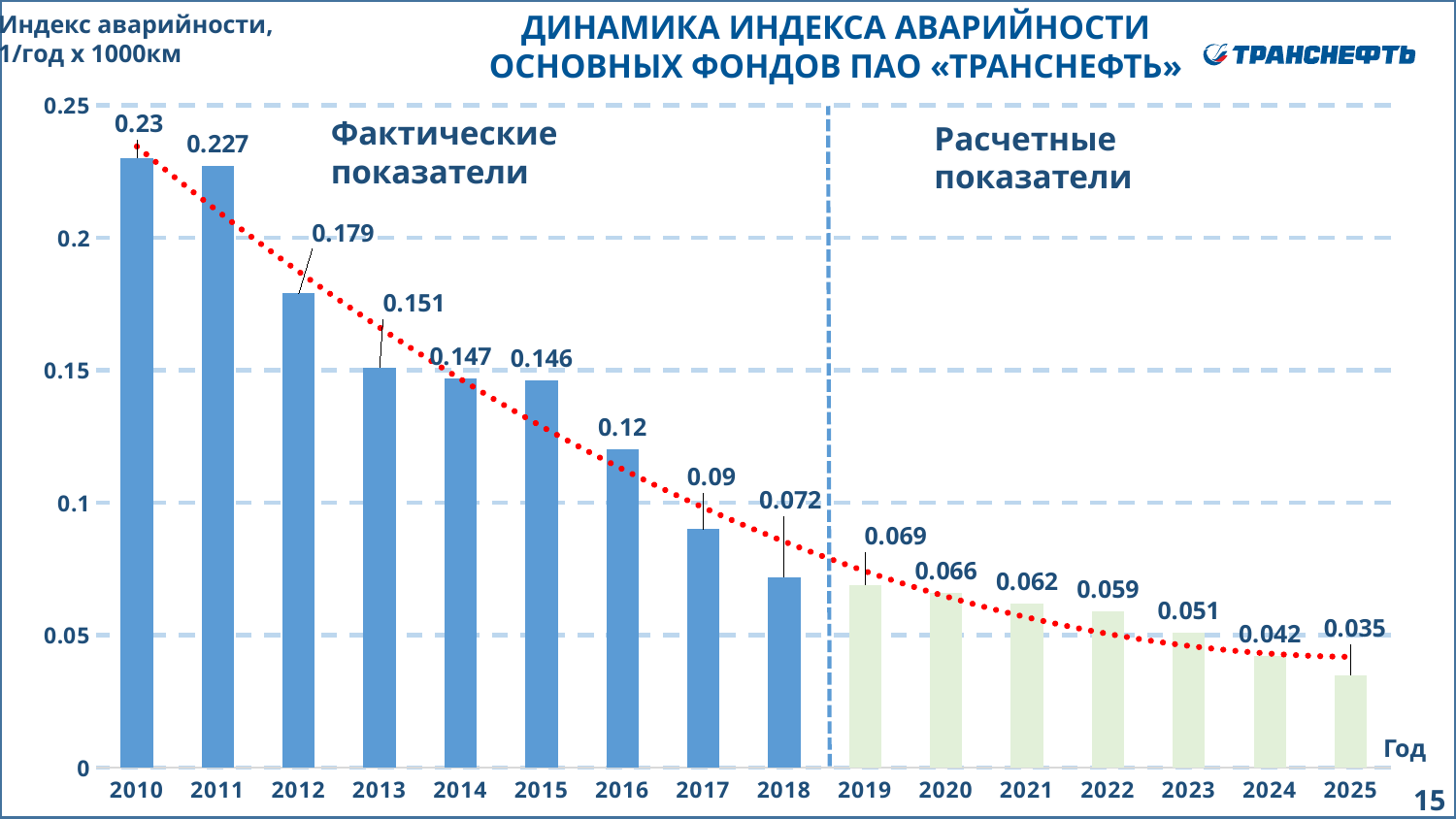
What is the accident index value for 2019? 0.069 How many years are shown on the x axis of the chart? 16 What is the accident index value for 2016? 0.12 What kind of chart is shown on the slide? bar chart What is the accident index value for 2025? 0.035 Which year has a larger accident index value, 2012 or 2016? 2012 Which year has the highest accident index value? 2010 Which year has the lowest accident index value? 2025 What is the accident index value for 2010? 0.23 Is the value for 2017 greater or less than 0.1? less What is the difference between the accident index values for 2010 and 2018? 0.158 Do the accident index values rise or fall from 2010 to 2025? fall